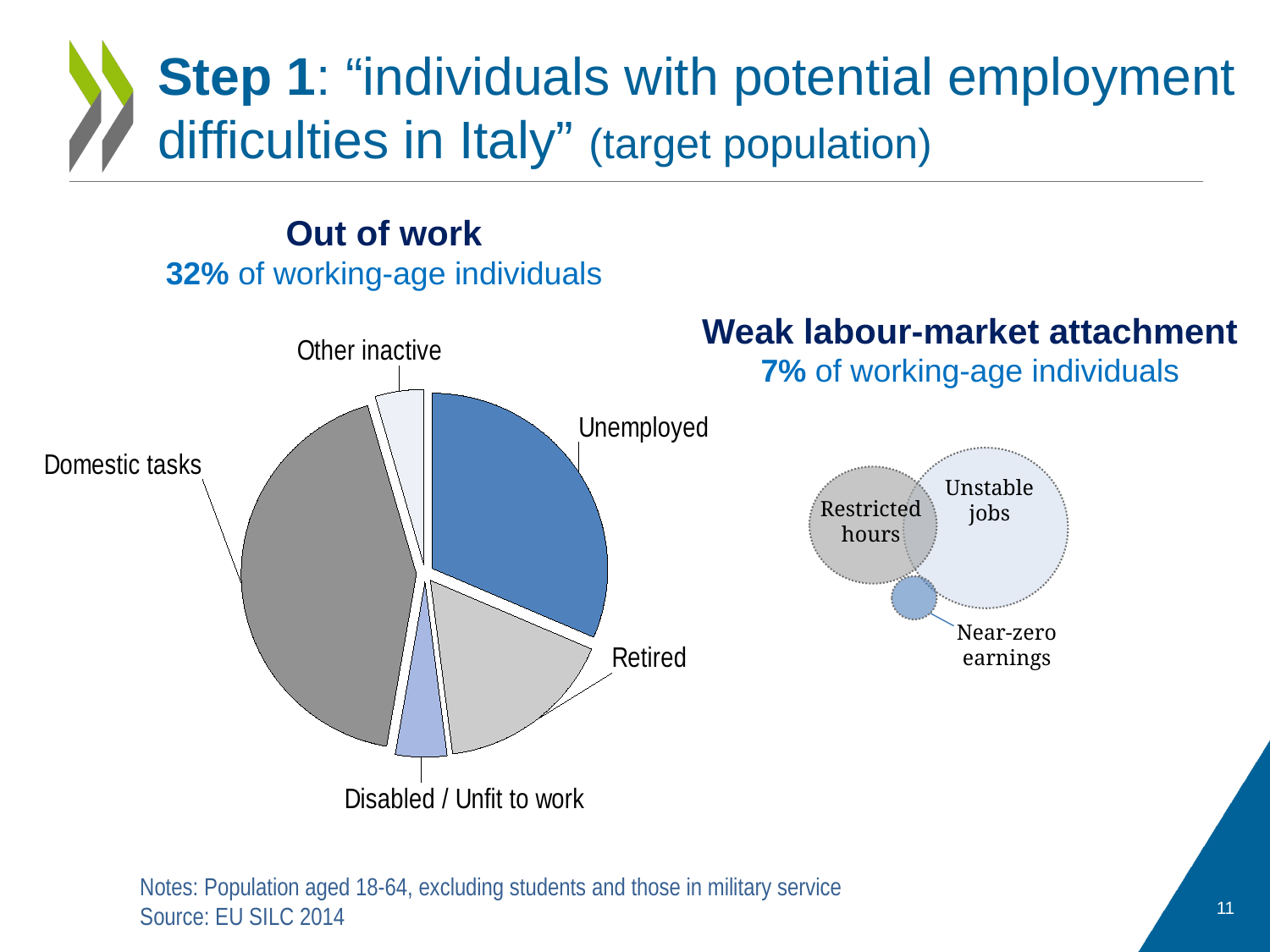
In the "Out of work" pie chart, which slice is larger: Domestic tasks or Other inactive? Domestic tasks According to the heading above the bubble diagram on the right, what share of working-age individuals have weak labour-market attachment? 7% Which category has the largest slice in the "Out of work" pie chart? Domestic tasks How many labelled circles are in the "Weak labour-market attachment" diagram on the right? 3 How many slices does the "Out of work" pie chart have? 5 According to the heading above the pie chart, what share of working-age individuals are out of work? 32% In the "Out of work" pie chart, which slice is larger: Unemployed or Retired? Unemployed Which slice of the "Out of work" pie chart is coloured dark blue? Unemployed In the "Out of work" pie chart, which slice is larger: Domestic tasks or Unemployed? Domestic tasks What kind of chart is the "Out of work" chart on the left of the slide? pie chart